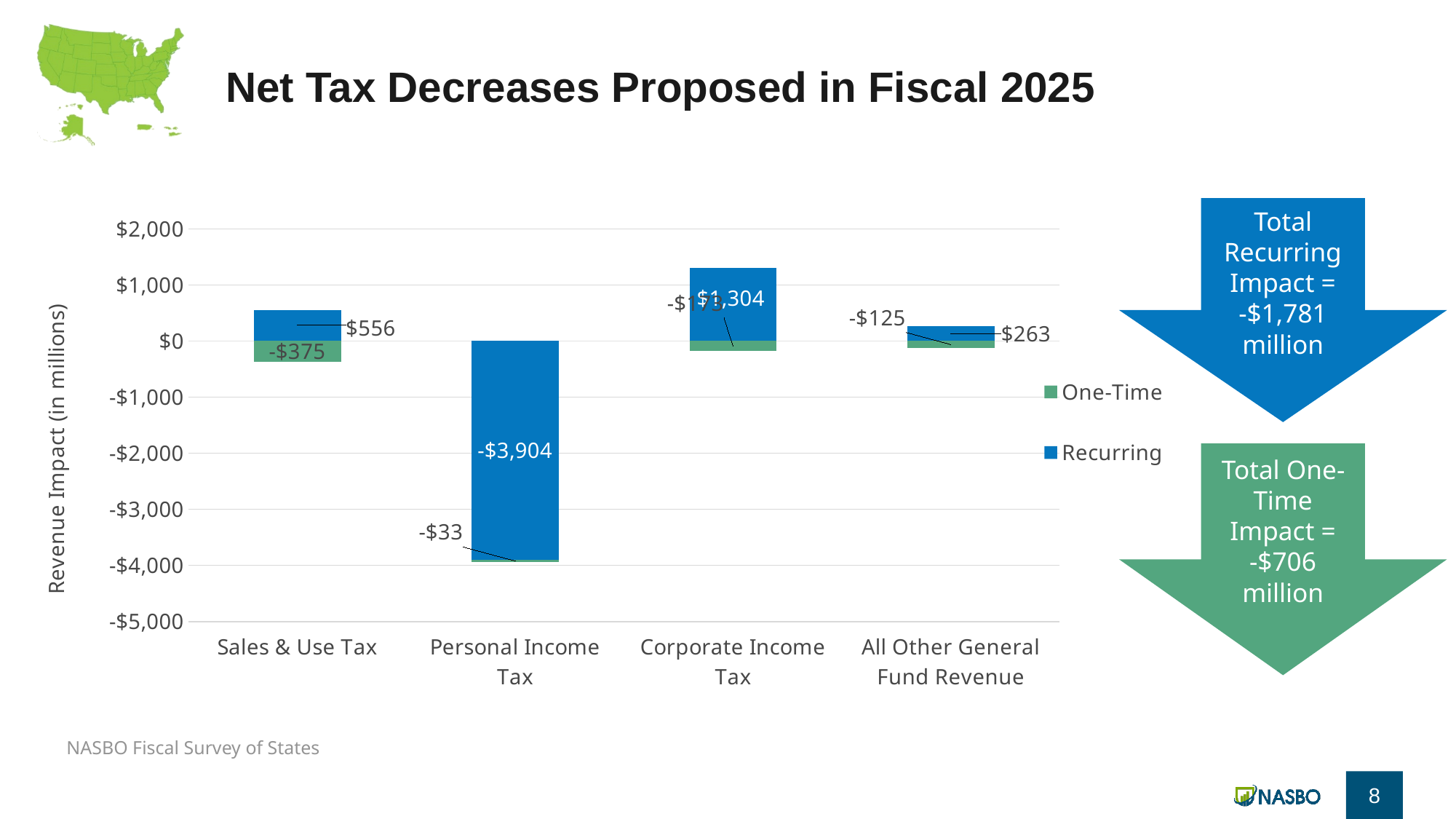
How many tax categories are shown on the x axis? 4 What is the Recurring revenue impact for Sales & Use Tax? $556 What is the One-Time revenue impact for Sales & Use Tax? -$375 What is the Recurring revenue impact for Corporate Income Tax? $1,304 What is the difference between the Recurring revenue impact for Sales & Use Tax and for All Other General Fund Revenue? $293 Which category has the lowest Recurring revenue impact? Personal Income Tax Which category has the highest Recurring revenue impact? Corporate Income Tax What is the One-Time revenue impact for Personal Income Tax? -$33 How many series does the legend list? 2 What is the One-Time revenue impact for All Other General Fund Revenue? -$125 What is the Recurring revenue impact for Personal Income Tax? -$3,904 What kind of chart is shown on the slide? bar chart